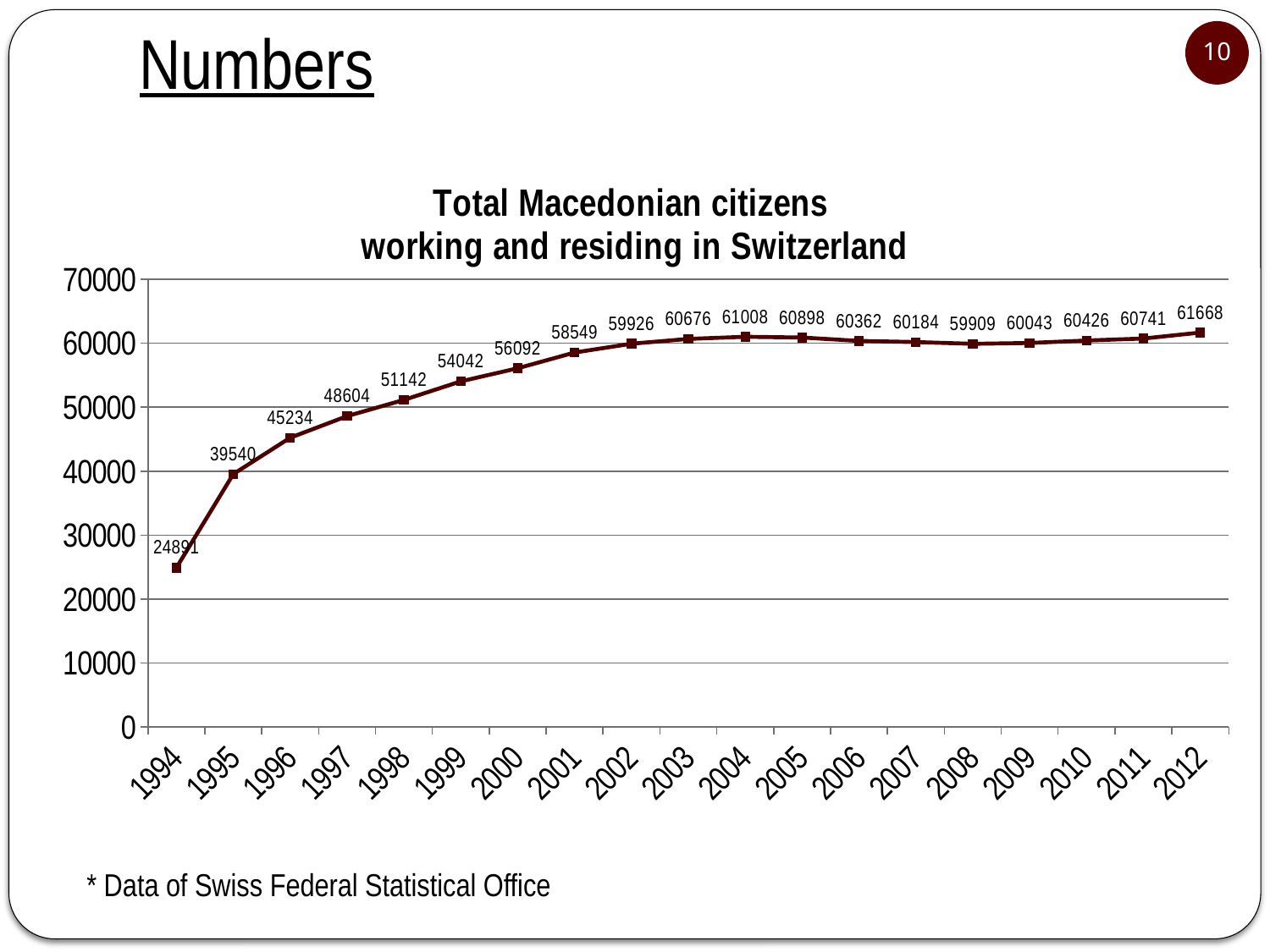
What is the value for 2012? 61668 Which year has the lowest value? 1994 What type of chart is shown on the slide? line chart Which is larger, the value for 2004 or the value for 2005? 2004 What is the difference between the values for 1995 and 1994? 14649 Do the values generally rise or fall from 1994 to 2001? rise Which year has the highest value? 2012 What is the value for 1994? 24891 What is the difference between the values for 2012 and 1994? 36777 What is the value for 2004? 61008 What is the title of the chart? Total Macedonian citizens working and residing in Switzerland How many years are plotted on the x axis? 19